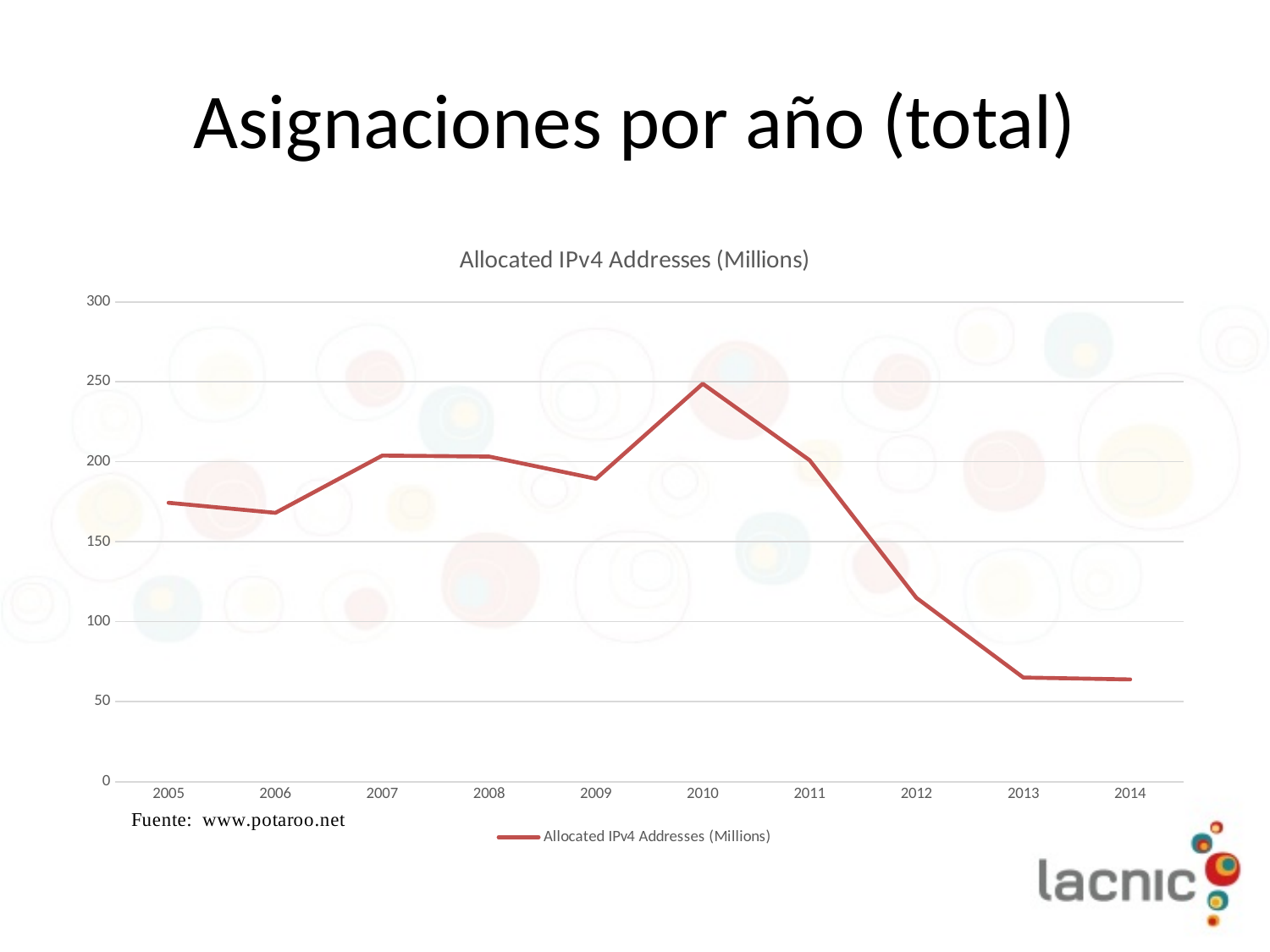
Is the value for 2005 greater or less than 150? greater What kind of chart is shown on the slide? line chart Is the value for 2013 greater or less than 100? less Which year has the larger value, 2010 or 2012? 2010 How many series does the chart's legend list? 1 In which year is the value of Allocated IPv4 Addresses (Millions) highest? 2010 How many years are plotted along the x axis of the chart? 10 Do the values rise or fall from 2010 to 2014? fall Is the value for 2012 greater or less than 100? greater What is the title of the chart? Allocated IPv4 Addresses (Millions) Which year has the larger value, 2006 or 2007? 2007